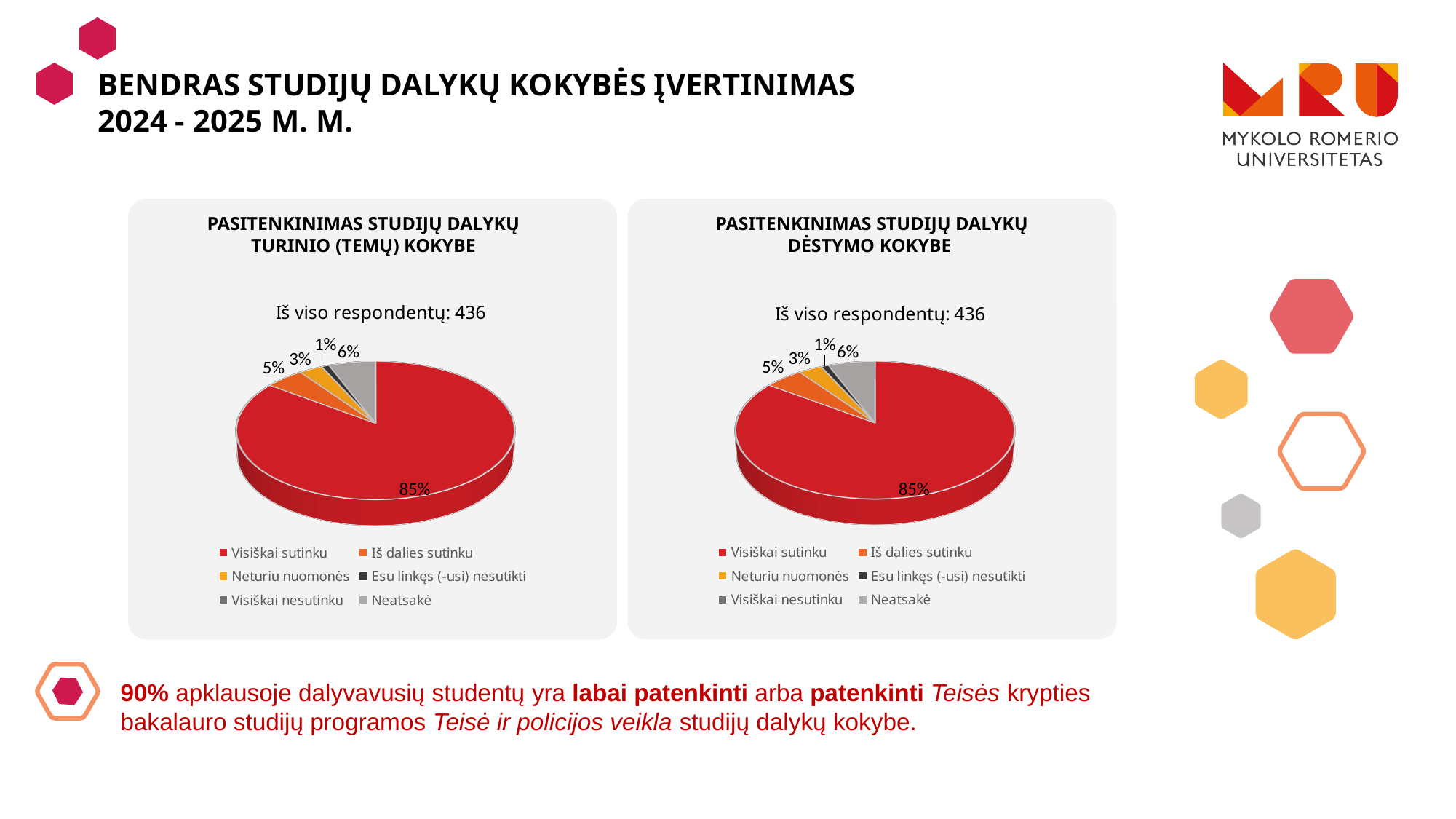
How many entries does the legend of the right chart (Pasitenkinimas studijų dalykų dėstymo kokybe) list? 6 What type of chart is used on this slide for the satisfaction results? Pie chart In the right chart (Pasitenkinimas studijų dalykų dėstymo kokybe), what share is labelled for 'Neatsakė'? 6% In the right chart (Pasitenkinimas studijų dalykų dėstymo kokybe), which response category has the largest slice? Visiškai sutinku In the left chart (Pasitenkinimas studijų dalykų turinio (temų) kokybe), what share of respondents answered 'Visiškai sutinku'? 85% In the left chart (Pasitenkinimas studijų dalykų turinio (temų) kokybe), what share is labelled for 'Iš dalies sutinku'? 5% In the left chart (Pasitenkinimas studijų dalykų turinio (temų) kokybe), what share is labelled for 'Neturiu nuomonės'? 3% In the left chart (Pasitenkinimas studijų dalykų turinio (temų) kokybe), which is larger: the 'Iš dalies sutinku' slice or the 'Neatsakė' slice? Neatsakė In the right chart (Pasitenkinimas studijų dalykų dėstymo kokybe), what is the difference between the 'Visiškai sutinku' share and the 'Neatsakė' share? 79 percentage points In the right chart (Pasitenkinimas studijų dalykų dėstymo kokybe), what share of respondents answered 'Visiškai sutinku'? 85% How many respondents in total are reported for the left chart (Pasitenkinimas studijų dalykų turinio (temų) kokybe)? 436 In the left chart (Pasitenkinimas studijų dalykų turinio (temų) kokybe), which labelled slice is the smallest? Esu linkęs (-usi) nesutikti (1%)